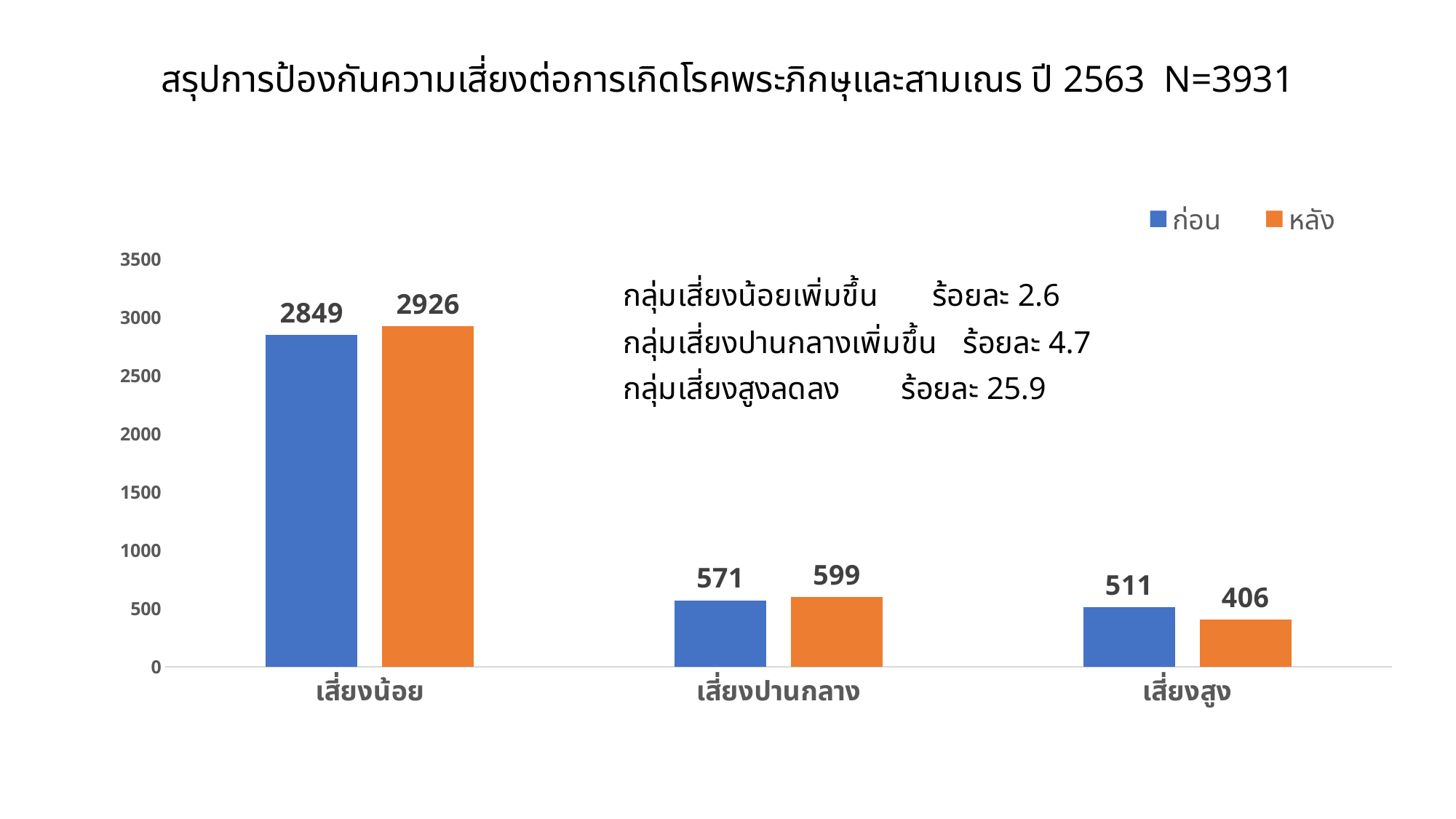
Which colour represents the หลัง series? orange What kind of chart is shown on the slide? bar chart Which category has the highest ก่อน value? เสี่ยงน้อย What is the difference between the หลัง and ก่อน values for เสี่ยงน้อย? 77 What is the value of หลัง for เสี่ยงปานกลาง? 599 How many categories are shown on the x axis? 3 What is the difference between the ก่อน and หลัง values for เสี่ยงสูง? 105 How many series does the legend list? 2 For เสี่ยงปานกลาง, which is larger: ก่อน or หลัง? หลัง What is the value of ก่อน for เสี่ยงน้อย? 2849 Which category has the lowest หลัง value? เสี่ยงสูง What is the value of หลัง for เสี่ยงสูง? 406